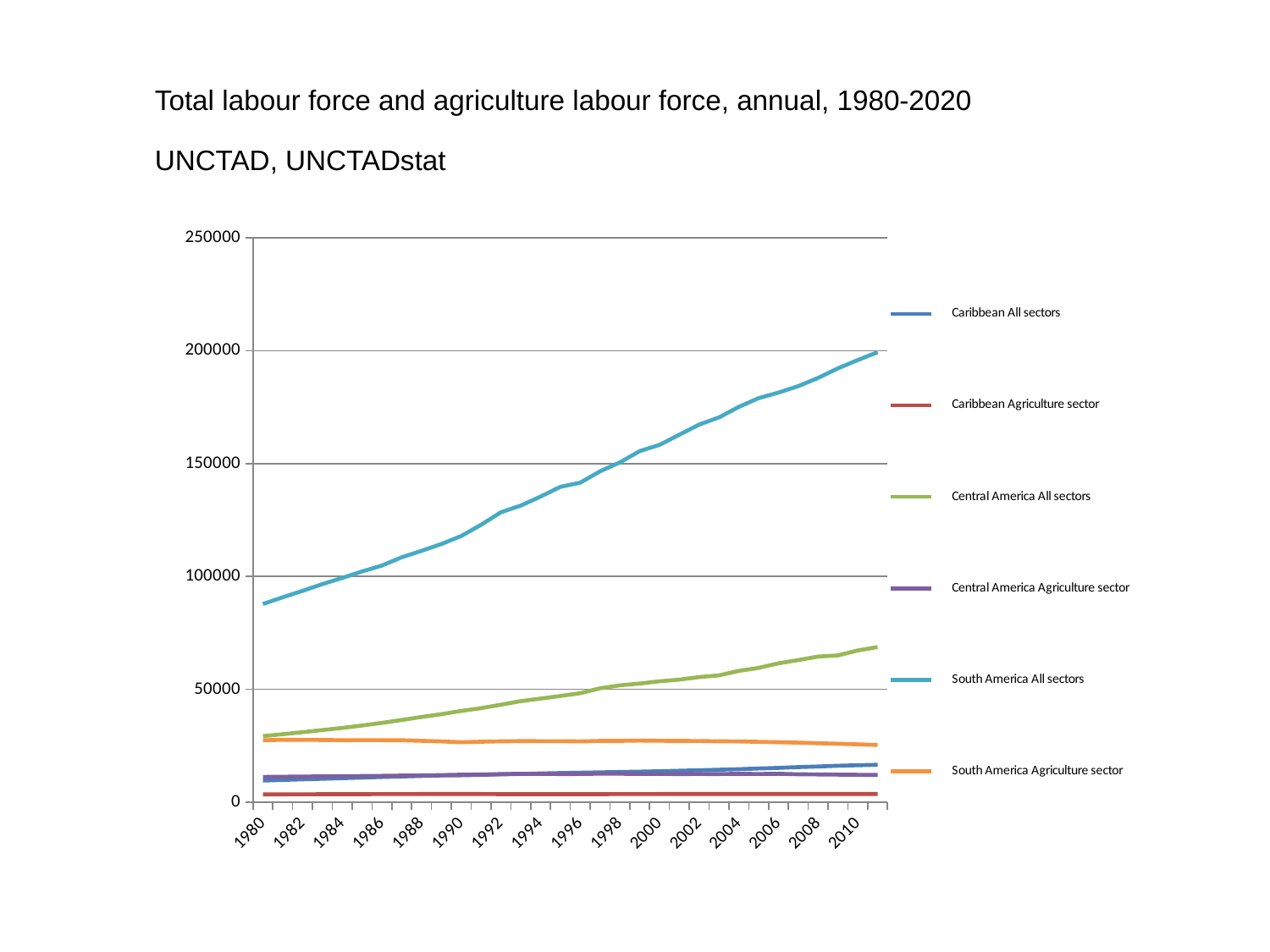
Which series has the highest values across the whole chart? South America All sectors Is the value for Central America All sectors in 2010 greater or less than 50000? greater How many series does the legend list? 6 Does the South America All sectors line rise or fall from 1980 to 2010? rise What is the highest value shown on the vertical axis? 250000 Is the value for Central America All sectors in 1980 greater or less than 50000? less In 2010, which is larger: Central America All sectors or South America Agriculture sector? Central America All sectors Which series has the lowest values across the whole chart? Caribbean Agriculture sector What kind of chart is shown on the slide? Line chart What is the title of the slide? Total labour force and agriculture labour force, annual, 1980-2020 Is the value for South America All sectors in 2010 greater or less than 150000? greater